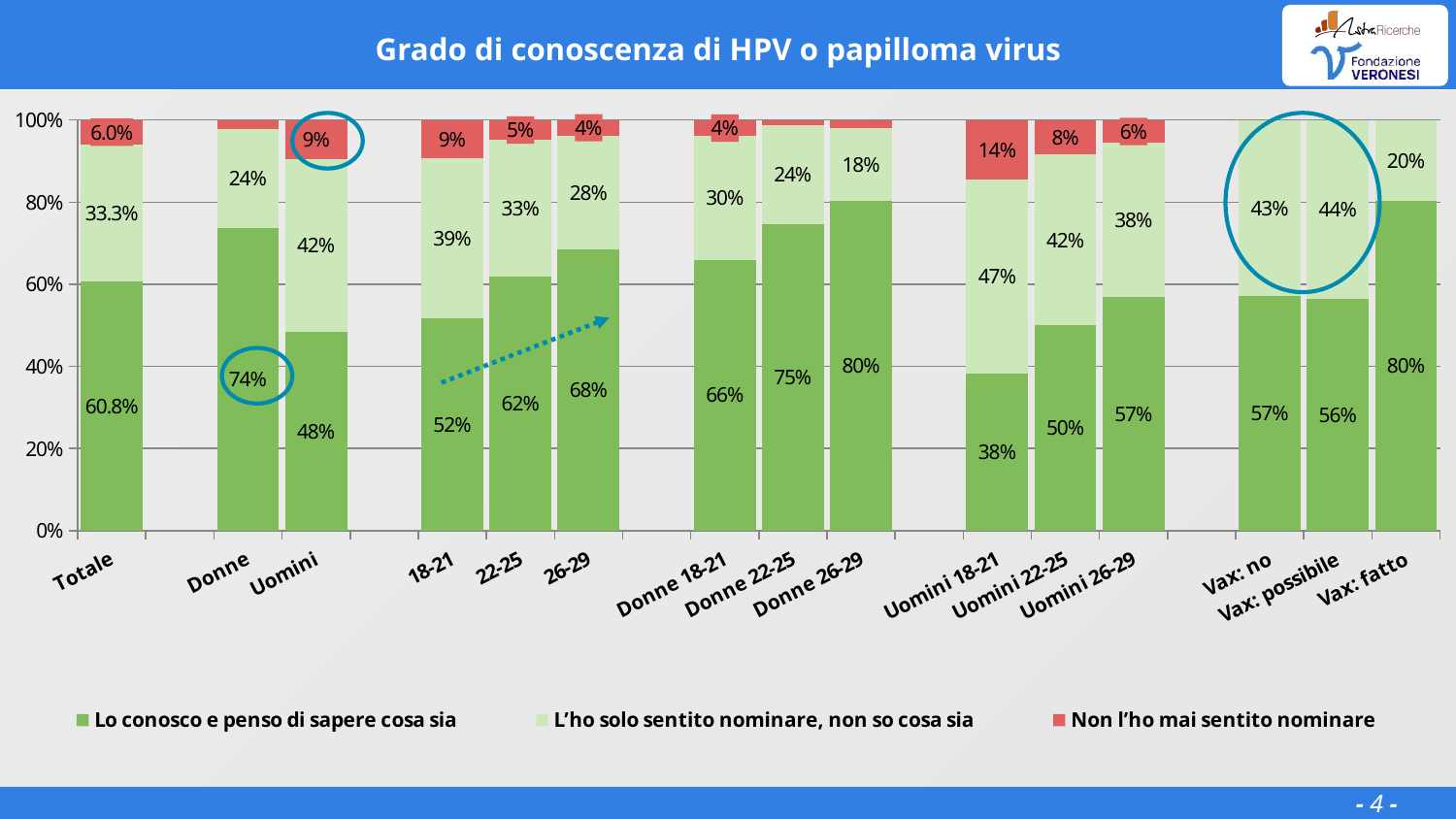
How many categories are shown on the x axis of the chart? 15 What is the title of the chart? Grado di conoscenza di HPV o papilloma virus Across the age groups 18-21, 22-25 and 26-29, does the value for "Lo conosco e penso di sapere cosa sia" rise or fall? Rise Which has a higher value for "Lo conosco e penso di sapere cosa sia": Donne 22-25 or Uomini 22-25? Donne 22-25 Which category has the lowest value for "Lo conosco e penso di sapere cosa sia"? Uomini 18-21 What is the value of "L'ho solo sentito nominare, non so cosa sia" for Vax: fatto? 20% What type of chart is shown on the slide? Stacked bar chart What percentage of Uomini 18-21 answered "Non l'ho mai sentito nominare"? 14% What is the value of "Lo conosco e penso di sapere cosa sia" for the Totale category? 60.8% How many series does the legend list? 3 Which category has the highest value for "Non l'ho mai sentito nominare"? Uomini 18-21 What is the difference between Donne and Uomini for "Lo conosco e penso di sapere cosa sia"? 26 percentage points